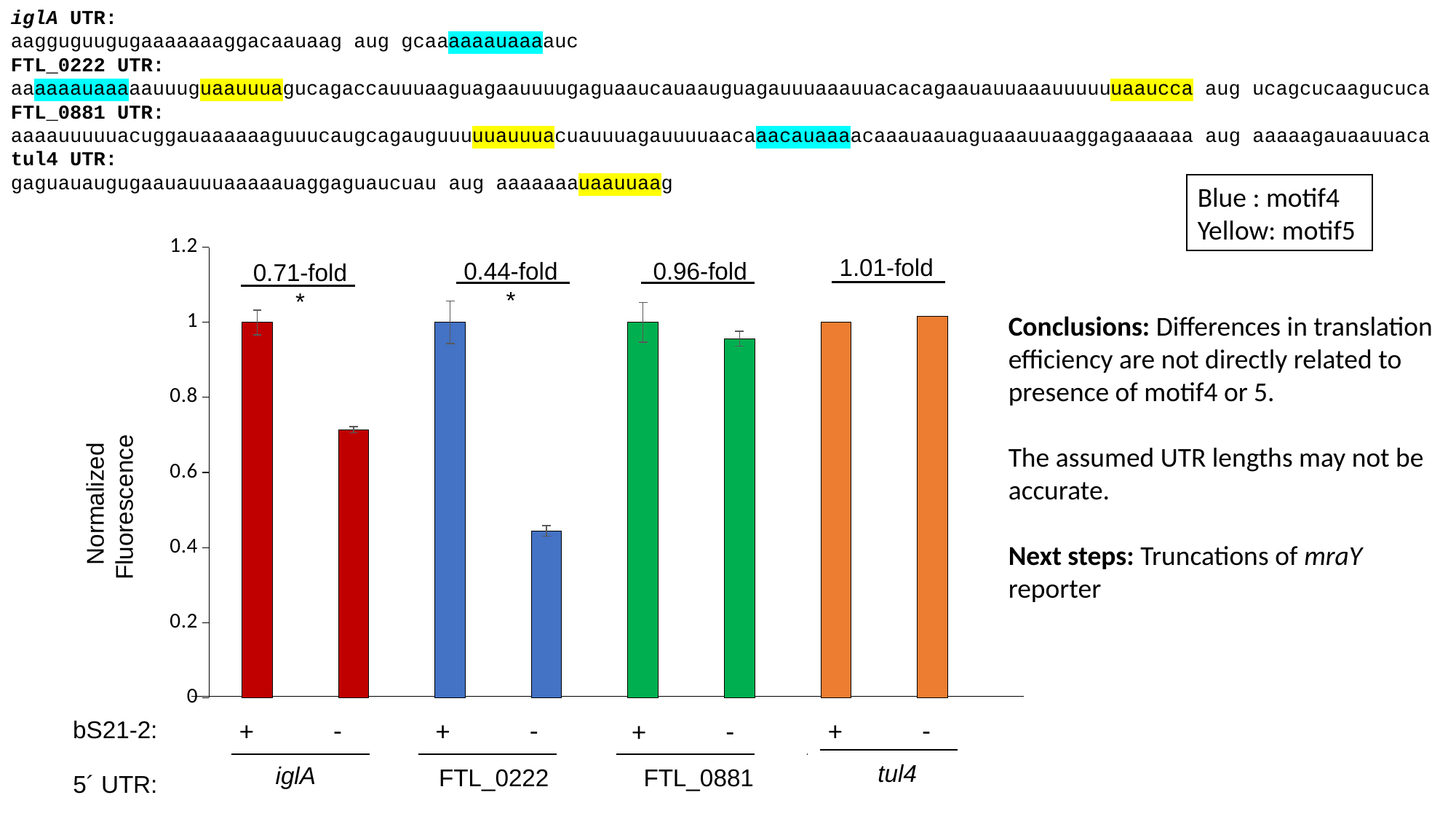
Is the normalized fluorescence for FTL_0222 with bS21-2 - greater or less than 0.6? less Is the normalized fluorescence for FTL_0881 with bS21-2 - greater or less than 0.8? greater Which is larger: the bS21-2 - bar for iglA or the bS21-2 - bar for FTL_0222? iglA Is the normalized fluorescence for iglA with bS21-2 - greater or less than 0.8? less What fold change is printed above the FTL_0881 pair of bars? 0.96-fold Which bar has the lowest normalized fluorescence? FTL_0222 with bS21-2 - How many 5' UTR groups are shown on the x axis of the chart? 4 What fold change is printed above the FTL_0222 pair of bars? 0.44-fold What fold change is printed above the iglA pair of bars? 0.71-fold What fold change is printed above the tul4 pair of bars? 1.01-fold What kind of chart is shown on the slide? bar chart What is the label of the y axis of the chart? Normalized Fluorescence